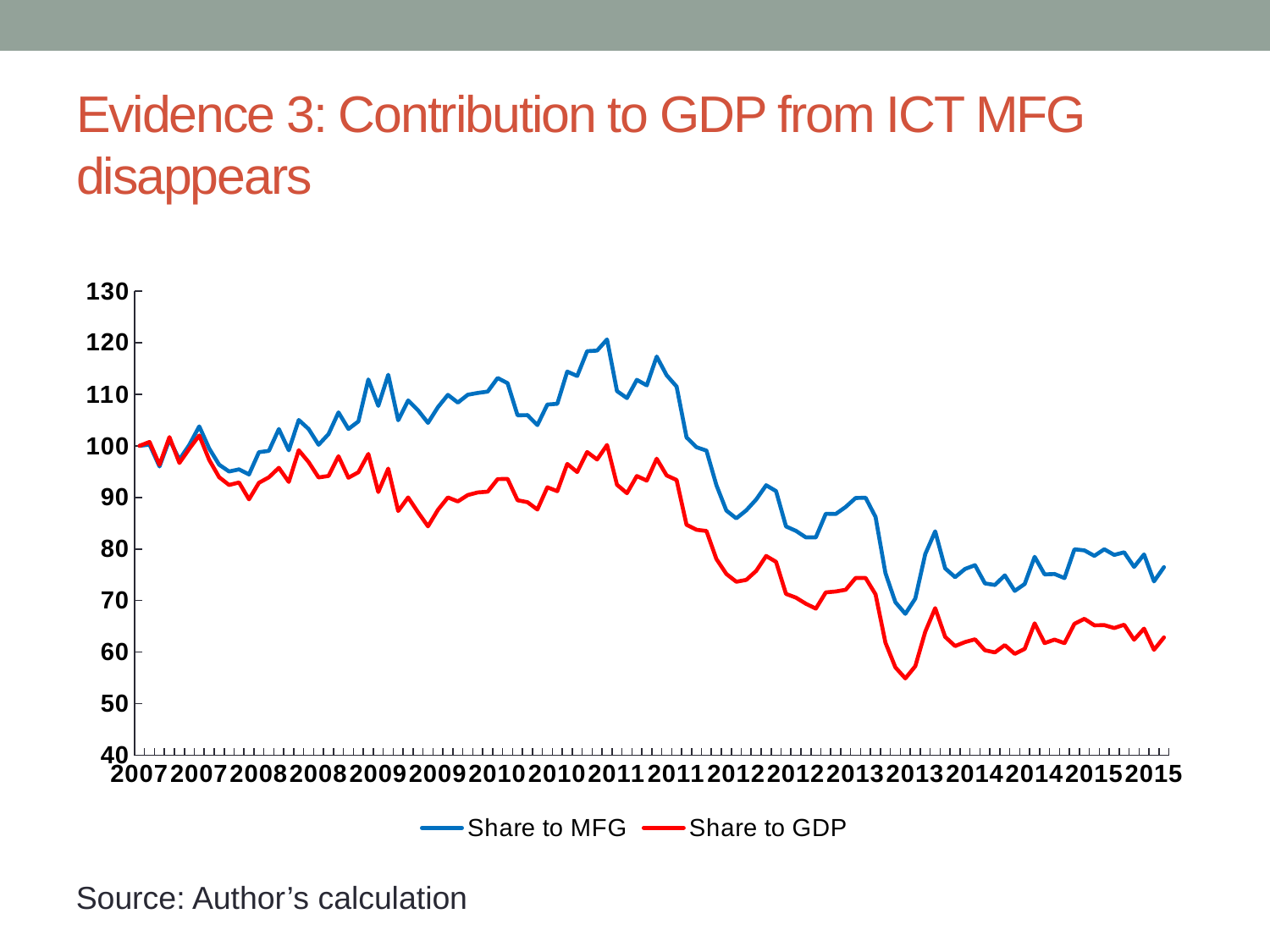
Overall, do the values of Share to MFG rise or fall from 2007 to 2015? fall Is the value of Share to MFG at the end of 2015 greater or less than 70? greater How many series does the legend list? 2 Is the highest value reached by Share to MFG in 2011 greater or less than 110? greater Which series is drawn in blue? Share to MFG Is the value of Share to GDP at the end of 2015 greater or less than 70? less Which series is drawn in red? Share to GDP Overall, do the values of Share to GDP rise or fall from 2007 to 2015? fall Which series reaches the lowest value anywhere on the chart? Share to GDP What kind of chart is shown on the slide? line chart At the end of 2015, which series is higher, Share to MFG or Share to GDP? Share to MFG